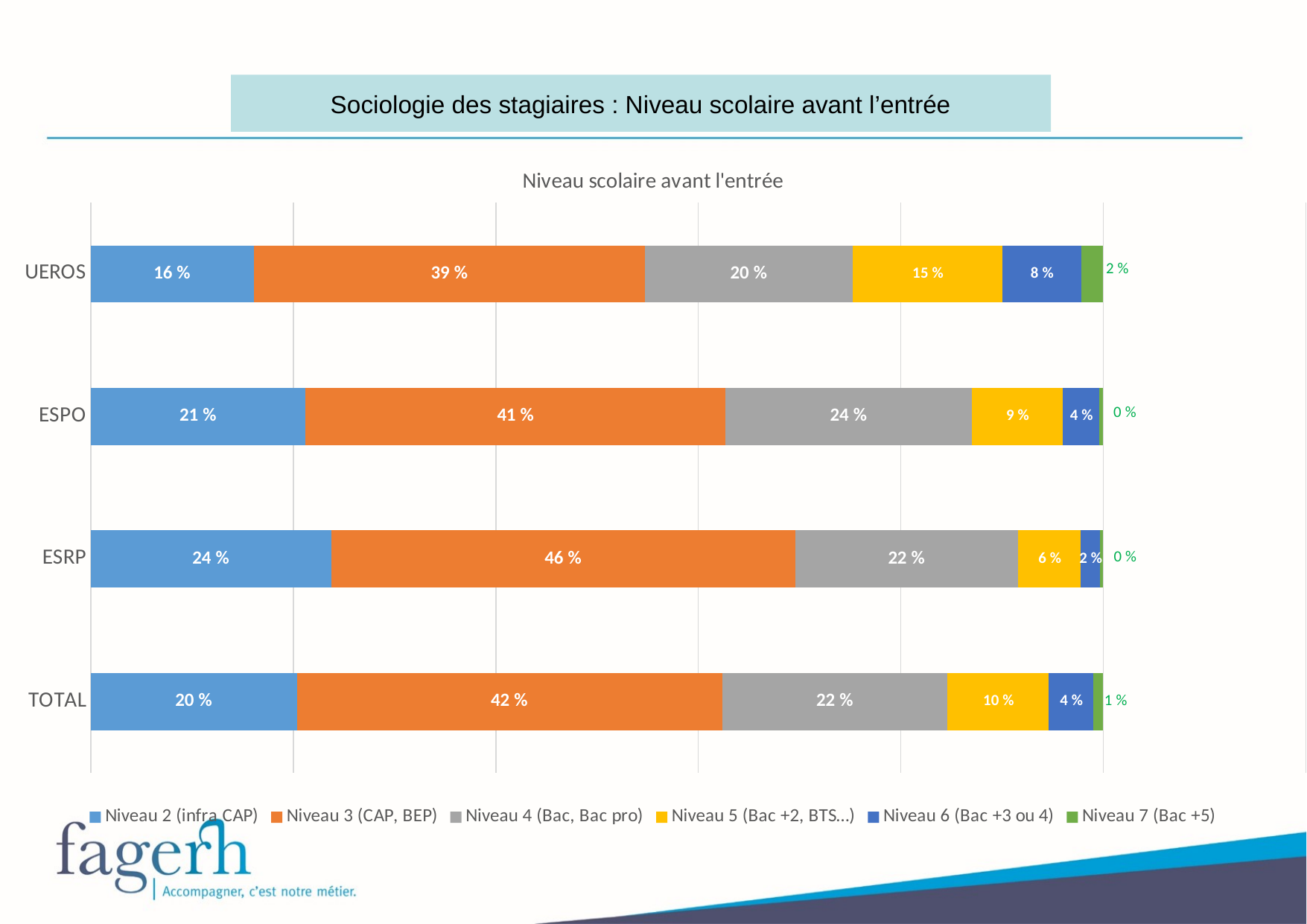
What is the value for Niveau 2 (infra CAP) in the UEROS bar? 16 % How many categories are shown on the y axis? 4 What is the difference between the Niveau 4 (Bac, Bac pro) values for ESPO and UEROS? 4 % How many series does the legend list? 6 What kind of chart is shown? Stacked bar chart What is the value for Niveau 7 (Bac +5) in the TOTAL bar? 1 % Which category has the highest value for Niveau 3 (CAP, BEP)? ESRP What is the value for Niveau 5 (Bac +2, BTS...) in the ESPO bar? 9 % Which is larger: the Niveau 6 (Bac +3 ou 4) value for UEROS or for ESRP? UEROS Which category has the lowest value for Niveau 2 (infra CAP)? UEROS What is the title of the chart? Niveau scolaire avant l'entrée What is the value for Niveau 3 (CAP, BEP) in the ESRP bar? 46 %